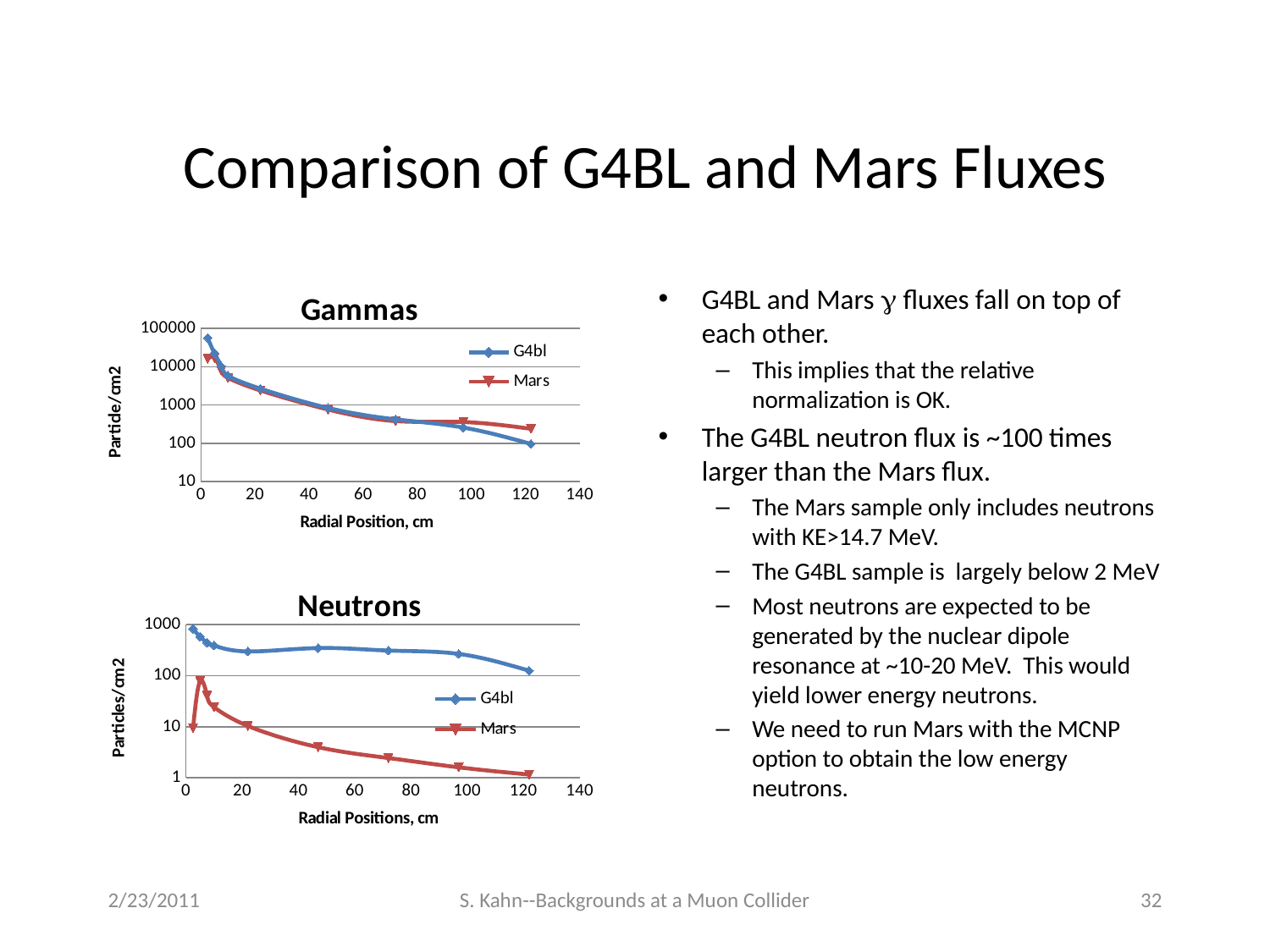
What kind of chart is the Gammas chart? line chart In the Neutrons chart, is the Mars value at a radial position of 120 cm greater or less than 10? less In the Neutrons chart, is the G4bl value at a radial position of 20 cm greater or less than 100? greater In the Neutrons chart, which series has the larger value at a radial position of 60 cm, G4bl or Mars? G4bl In the Gammas chart, is the Mars value at a radial position of 120 cm greater or less than 100? greater In the Neutrons chart, does the Mars series rise or fall from 20 cm to 120 cm? fall What kind of chart is the Neutrons chart? line chart In the Gammas chart, what is the label of the y axis? Particle/cm2 How many series does the legend of the Neutrons chart list? 2 How many series does the legend of the Gammas chart list? 2 In the Neutrons chart, what is the label of the x axis? Radial Positions, cm In the Gammas chart, does the G4bl series rise or fall as radial position increases? fall